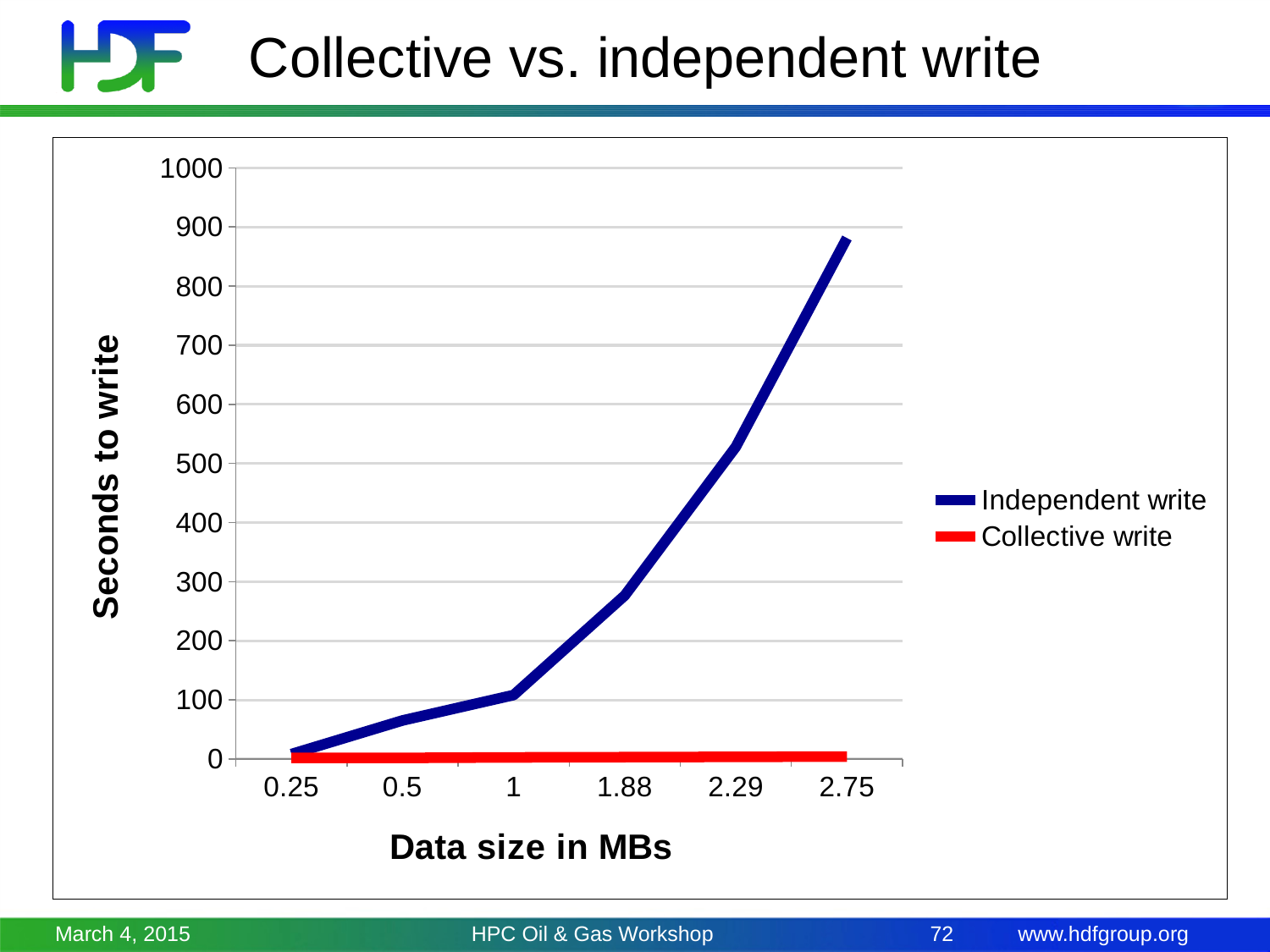
At which data size is the Independent write value highest? 2.75 At 2.75 MBs, which series has the larger value, Independent write or Collective write? Independent write How many series does the legend list? 2 At which data size is the Independent write value lowest? 0.25 Does the Independent write series rise or fall as data size increases along the x axis? rises Is the Independent write value at 2.29 MBs greater or less than 400? greater What kind of chart is shown on the slide? line chart How many data size points are shown along the x axis? 6 Is the Independent write value at 1.88 MBs greater or less than 200? greater What is the title of the y axis? Seconds to write Is the Collective write value at 2.75 MBs greater or less than 100? less